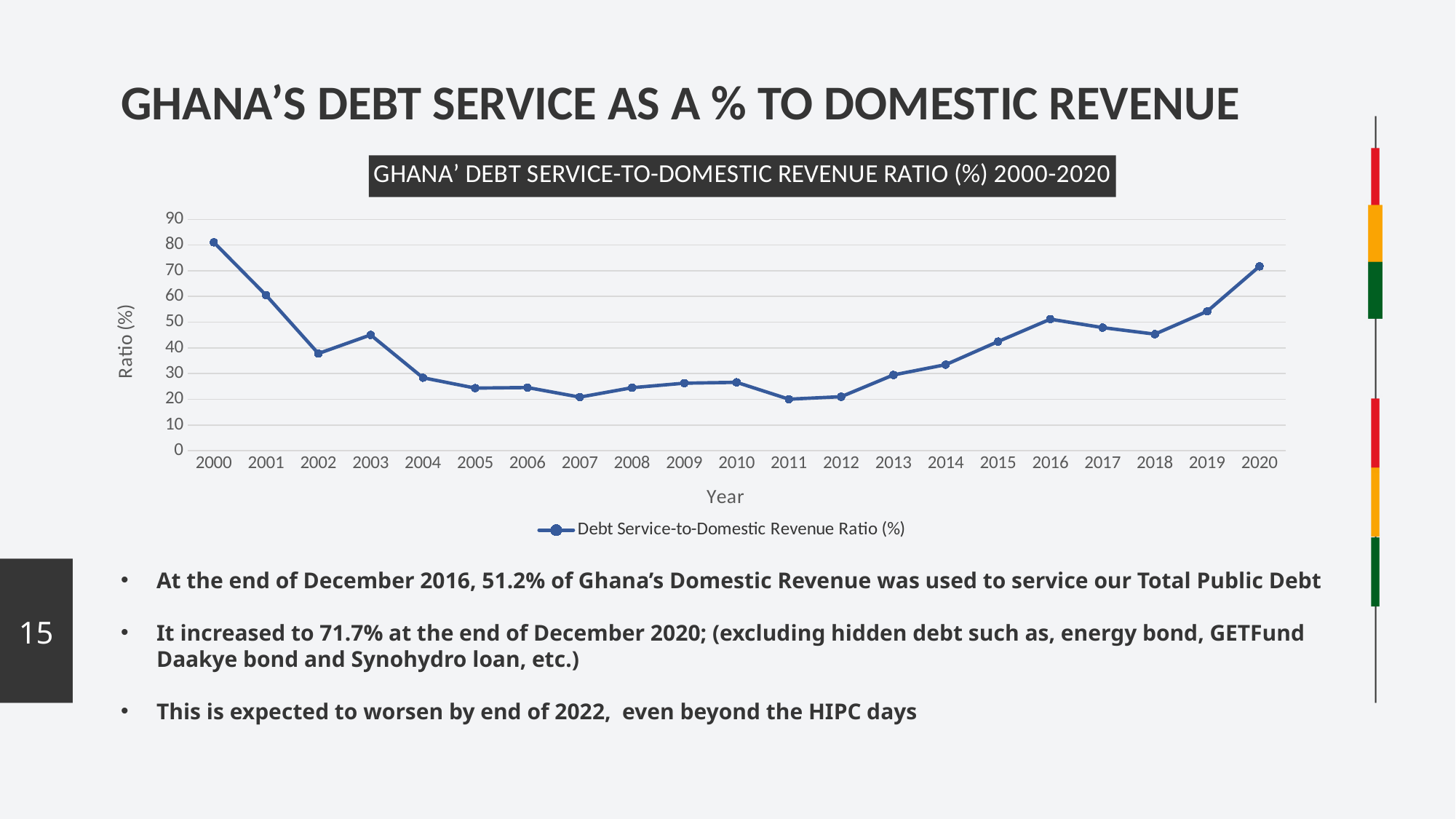
Does the ratio rise or fall from 2012 to 2016? rise How many years are plotted on the x axis of the chart? 21 Which year has the highest Debt Service-to-Domestic Revenue Ratio? 2000 What was the Debt Service-to-Domestic Revenue Ratio at the end of December 2016? 51.2% Is the ratio for 2000 greater or less than 70? greater Which year has the larger ratio, 2001 or 2002? 2001 Is the ratio for 2019 greater or less than 50? greater What kind of chart is shown on the slide? line chart By how many percentage points did the ratio increase from the end of 2016 to the end of 2020? 20.5 What was the Debt Service-to-Domestic Revenue Ratio at the end of December 2020? 71.7% How many series does the chart legend list? 1 Is the ratio for 2002 greater or less than 40? less